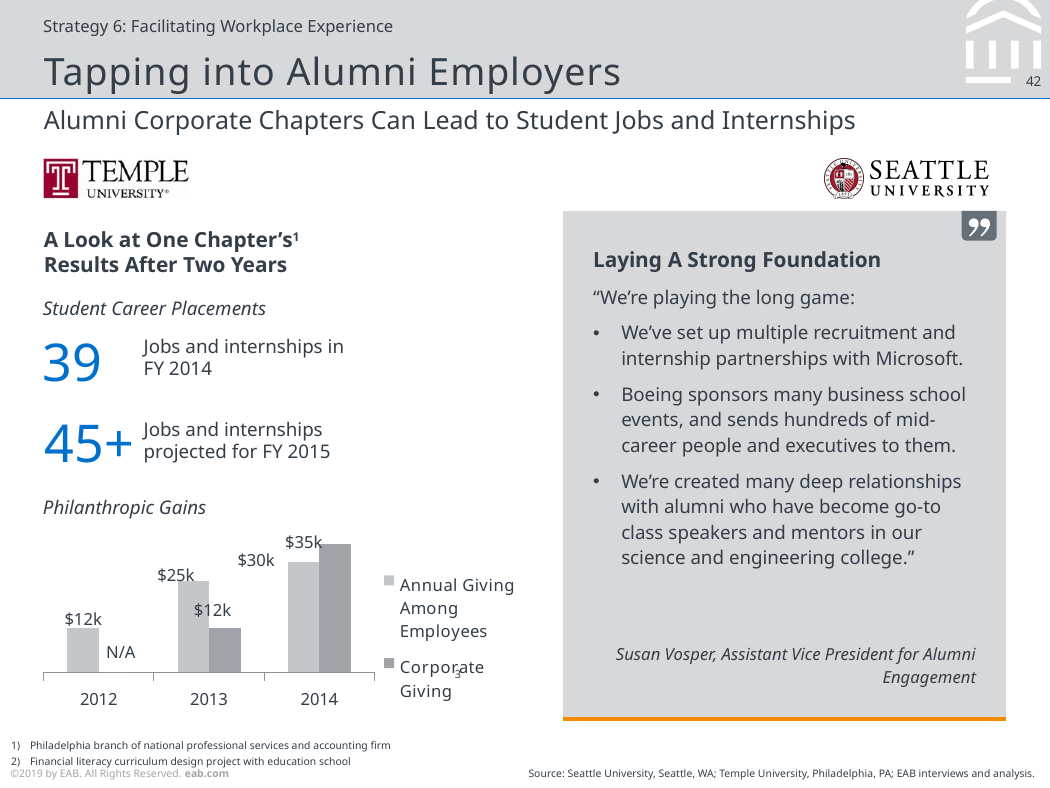
In the Philanthropic Gains chart, what is the value of Annual Giving Among Employees in 2013? $25k In the Philanthropic Gains chart, does Annual Giving Among Employees rise or fall from 2012 to 2014? rise In the Philanthropic Gains chart, what is the difference between Annual Giving Among Employees in 2014 and 2013? $5k How many series does the legend of the Philanthropic Gains chart list? 2 In the Philanthropic Gains chart, what is the value of Annual Giving Among Employees in 2012? $12k How many years are shown on the x axis of the Philanthropic Gains chart? 3 In the Philanthropic Gains chart, which year has the lowest Annual Giving Among Employees? 2012 In the Philanthropic Gains chart, what is the value of Corporate Giving in 2014? $35k What type of chart is shown under "Philanthropic Gains"? bar chart In the Philanthropic Gains chart, which is larger in 2014: Annual Giving Among Employees or Corporate Giving? Corporate Giving In the Philanthropic Gains chart, what is shown for Corporate Giving in 2012? N/A In the Philanthropic Gains chart, which year has the highest Annual Giving Among Employees? 2014